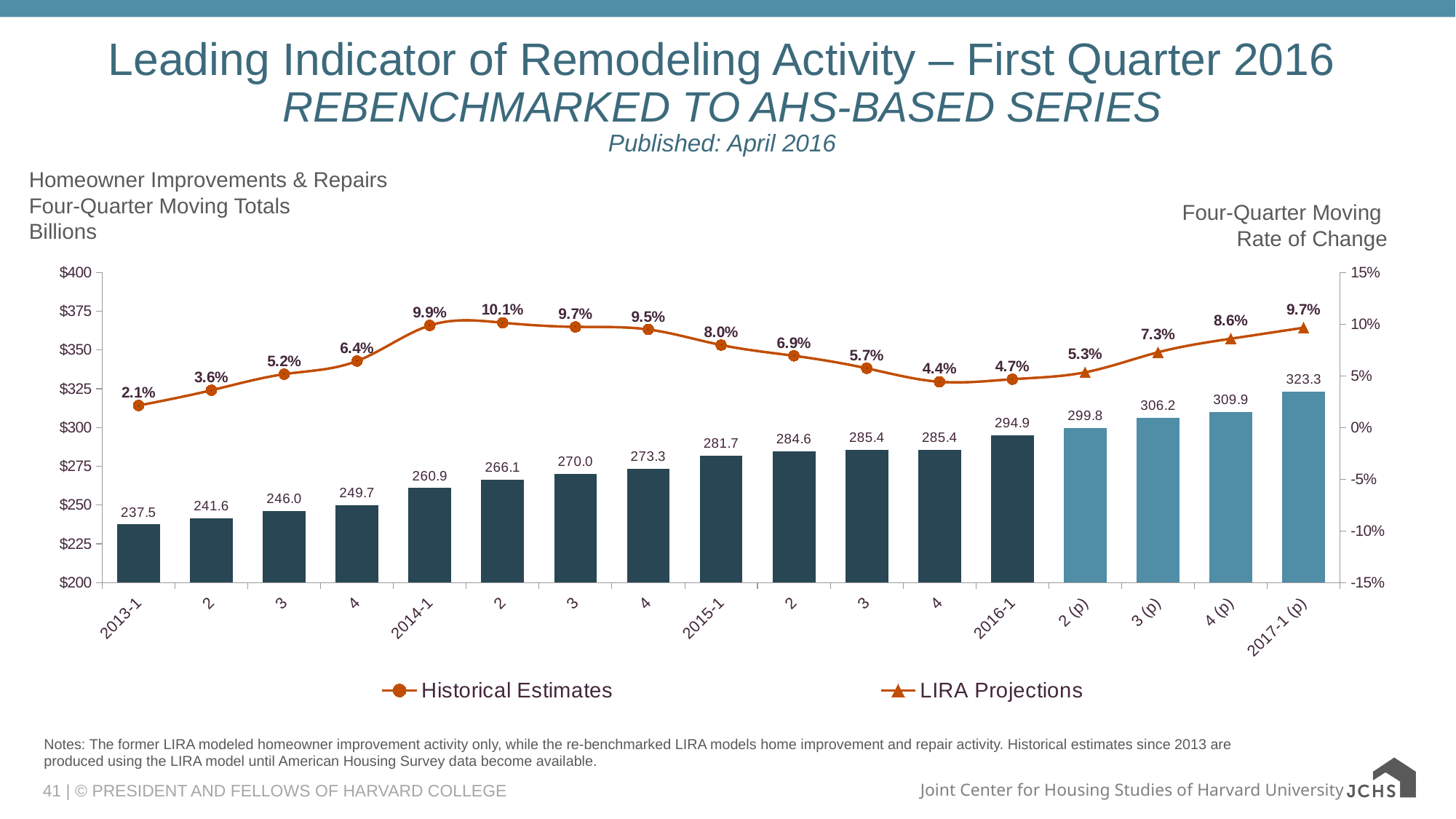
What kind of chart is this? Combined bar and line chart What are the two series named in the legend? Historical Estimates and LIRA Projections What is the projected four-quarter moving total for 2017-1 (p)? 323.3 What is the four-quarter moving total (in billions) shown for 2016-1? 294.9 How many series does the legend list? 2 What rate of change is labeled for 2014-2? 10.1% Do the four-quarter moving totals rise or fall from 2013-1 to 2017-1 (p)? Rise Which quarter has the highest four-quarter moving rate of change? 2014-2 Which is larger, the rate of change for 2015-4 or for 2016-1? 2016-1 What is the difference between the four-quarter moving totals for 2017-1 (p) and 2016-1? 28.4 How many quarters are plotted along the x axis? 17 Which quarter has the lowest four-quarter moving total? 2013-1